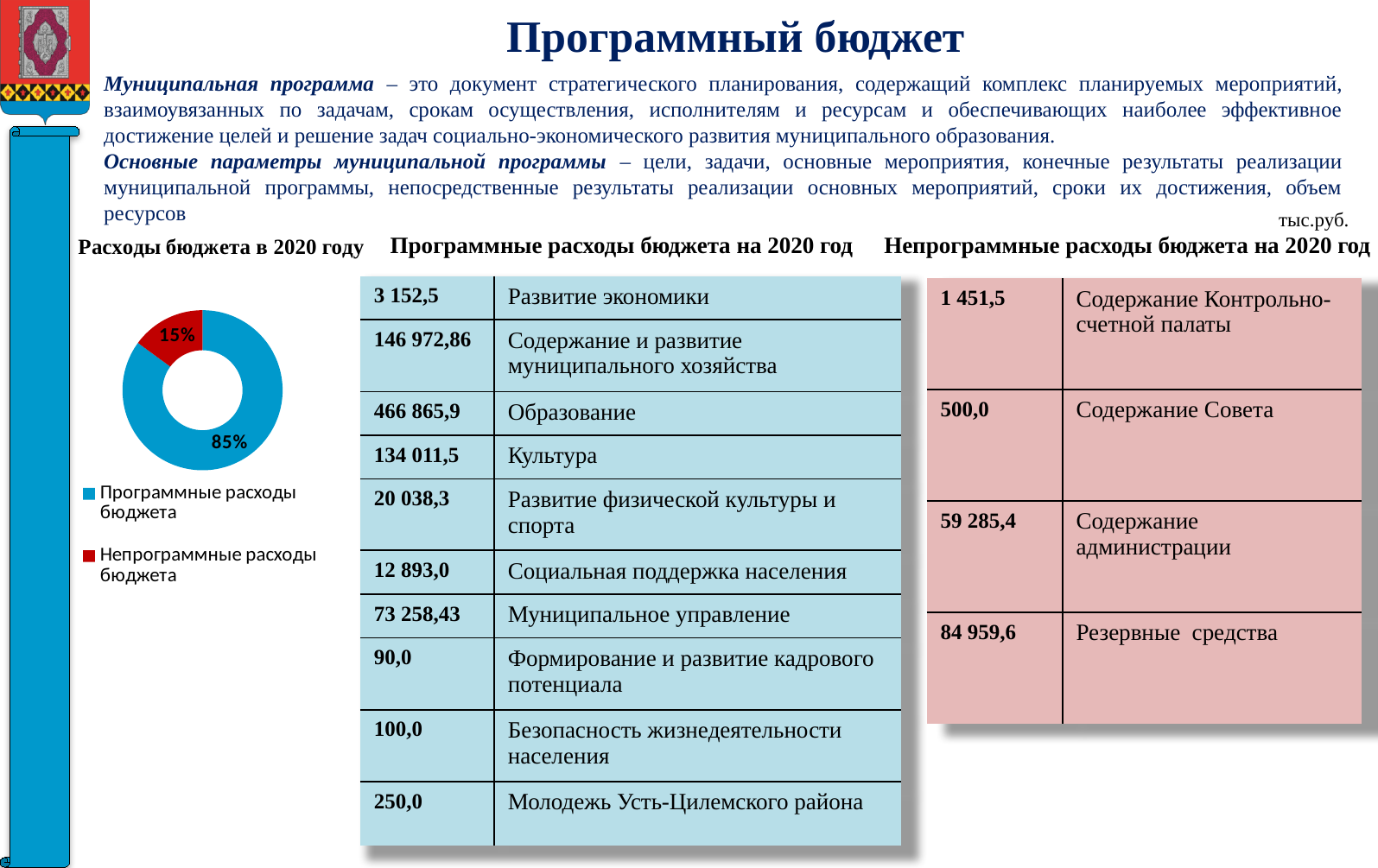
In the chart "Расходы бюджета в 2020 году", what share is labelled for "Непрограммные расходы бюджета"? 15% In the chart "Расходы бюджета в 2020 году", what colour represents "Непрограммные расходы бюджета"? Red In the chart "Расходы бюджета в 2020 году", which category has the smallest share? Непрограммные расходы бюджета In the chart "Расходы бюджета в 2020 году", which category has the largest share? Программные расходы бюджета In the chart "Расходы бюджета в 2020 году", what is the share of the slice labelled 15%? 15% How many slices does the chart "Расходы бюджета в 2020 году" have? 2 How many entries does the legend of the chart "Расходы бюджета в 2020 году" list? 2 In the chart "Расходы бюджета в 2020 году", what colour represents "Программные расходы бюджета"? Blue In the chart "Расходы бюджета в 2020 году", which is larger: "Программные расходы бюджета" or "Непрограммные расходы бюджета"? Программные расходы бюджета What kind of chart is shown under the heading "Расходы бюджета в 2020 году"? Doughnut (pie) chart In the chart "Расходы бюджета в 2020 году", what share is labelled for "Программные расходы бюджета"? 85% In the chart "Расходы бюджета в 2020 году", what is the difference in percentage points between the two slices? 70